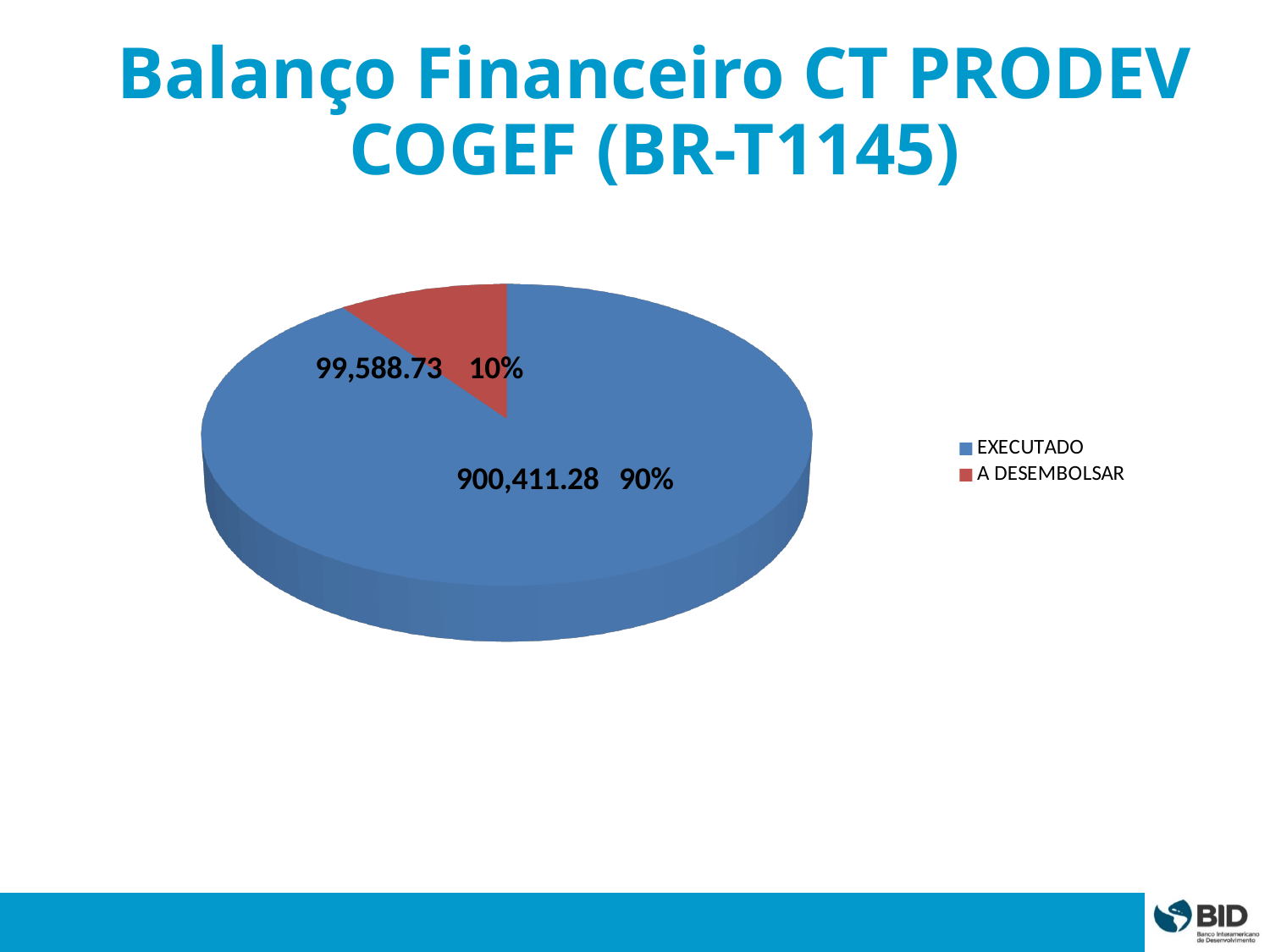
How many entries does the legend list? 2 What is the value for EXECUTADO? 900,411.28 What is the difference between the EXECUTADO value and the A DESEMBOLSAR value? 800,822.55 Which category has the smallest slice of the pie? A DESEMBOLSAR What share of the pie does A DESEMBOLSAR represent? 10% What share of the pie does EXECUTADO represent? 90% Which category has the largest slice of the pie? EXECUTADO What kind of chart is shown on the slide? pie chart Which is larger, EXECUTADO or A DESEMBOLSAR? EXECUTADO What is the value for A DESEMBOLSAR? 99,588.73 How many slices does the pie chart have? 2 What colour is the A DESEMBOLSAR slice? red